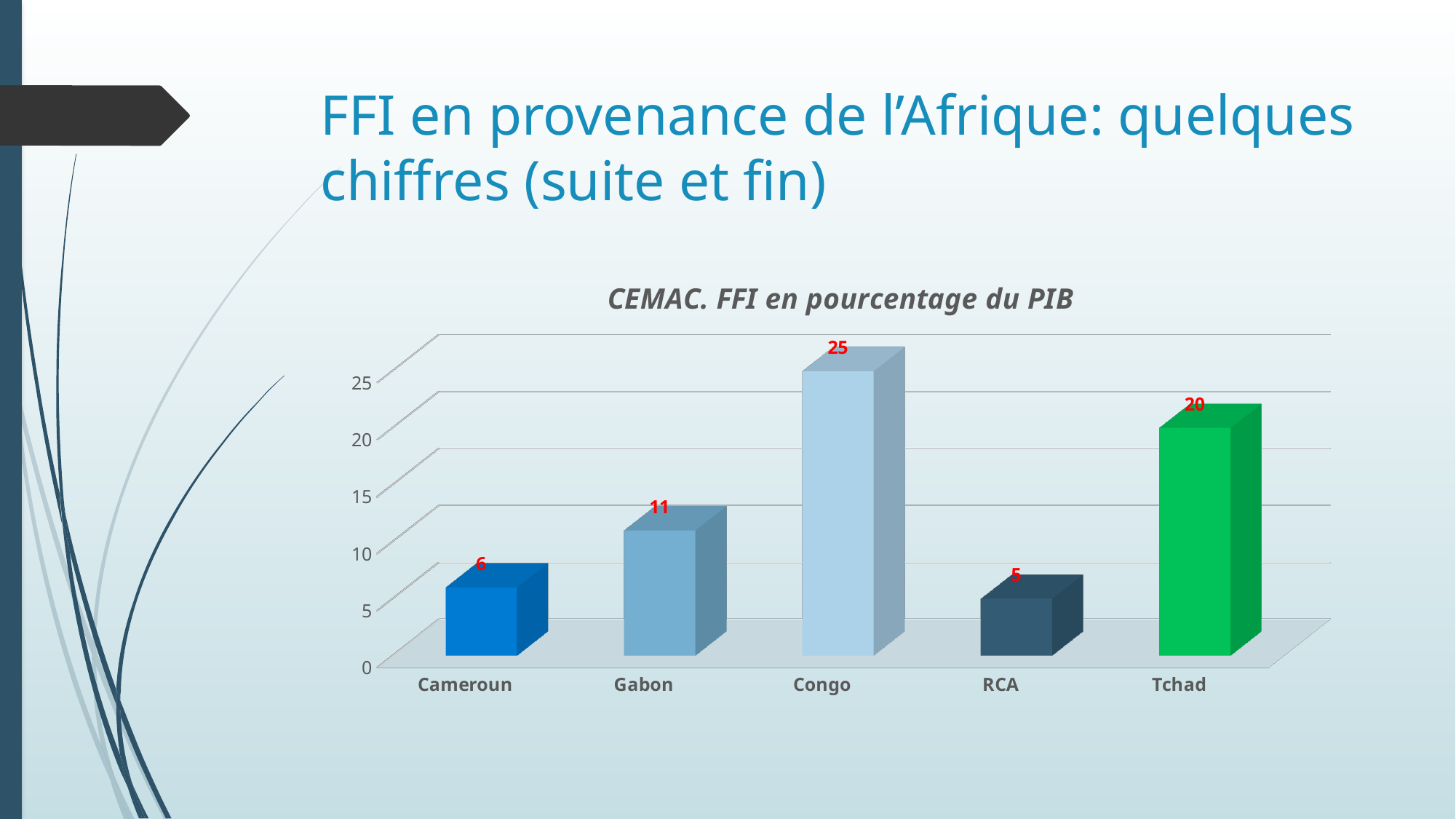
What is the value for Tchad? 20 What is the difference between the values for Congo and Tchad? 5 How many countries are shown on the chart? 5 What is the value for Congo? 25 What is the title of the chart? CEMAC. FFI en pourcentage du PIB What is the difference between the values for Gabon and Cameroun? 5 Is the value for Tchad greater or less than 15? greater Which country has the lowest value? RCA What kind of chart is shown on the slide? bar chart What is the value for Cameroun? 6 Which is larger, the value for Gabon or the value for RCA? Gabon Which country has the highest value? Congo